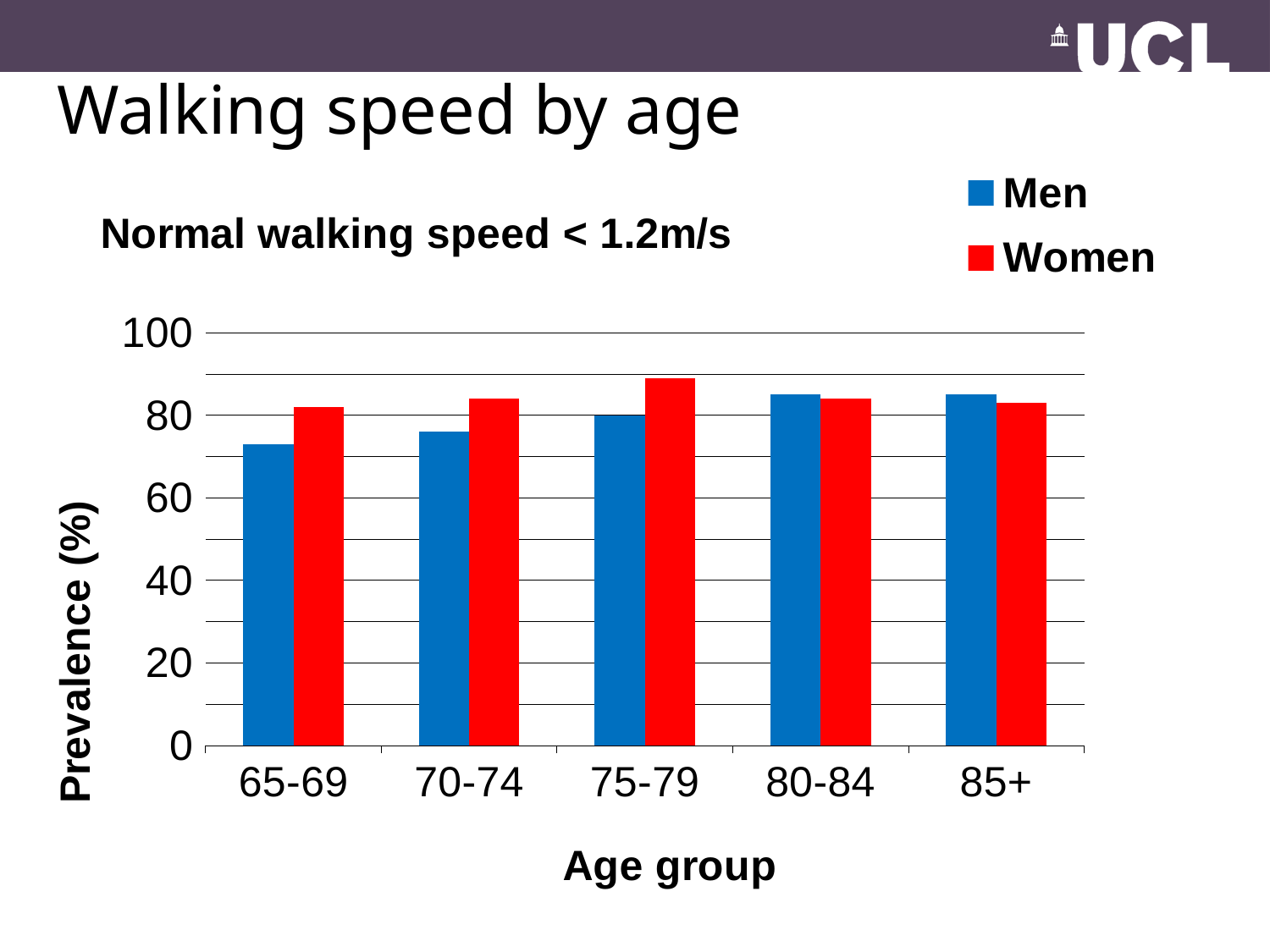
How many series does the legend list? 2 In the 65-69 age group, which series has the larger value, Men or Women? Women What kind of chart is shown on the slide? bar chart Which two series are listed in the legend? Men and Women Is the value for Women in the 75-79 age group greater or less than 80? greater How many age groups are shown on the x axis? 5 For which age group is the Men value lowest? 65-69 Is the value for Men in the 65-69 age group greater or less than 80? less For which age group is the Women value highest? 75-79 Is the value for Men in the 80-84 age group greater or less than 80? greater What is the title of the chart? Normal walking speed < 1.2m/s